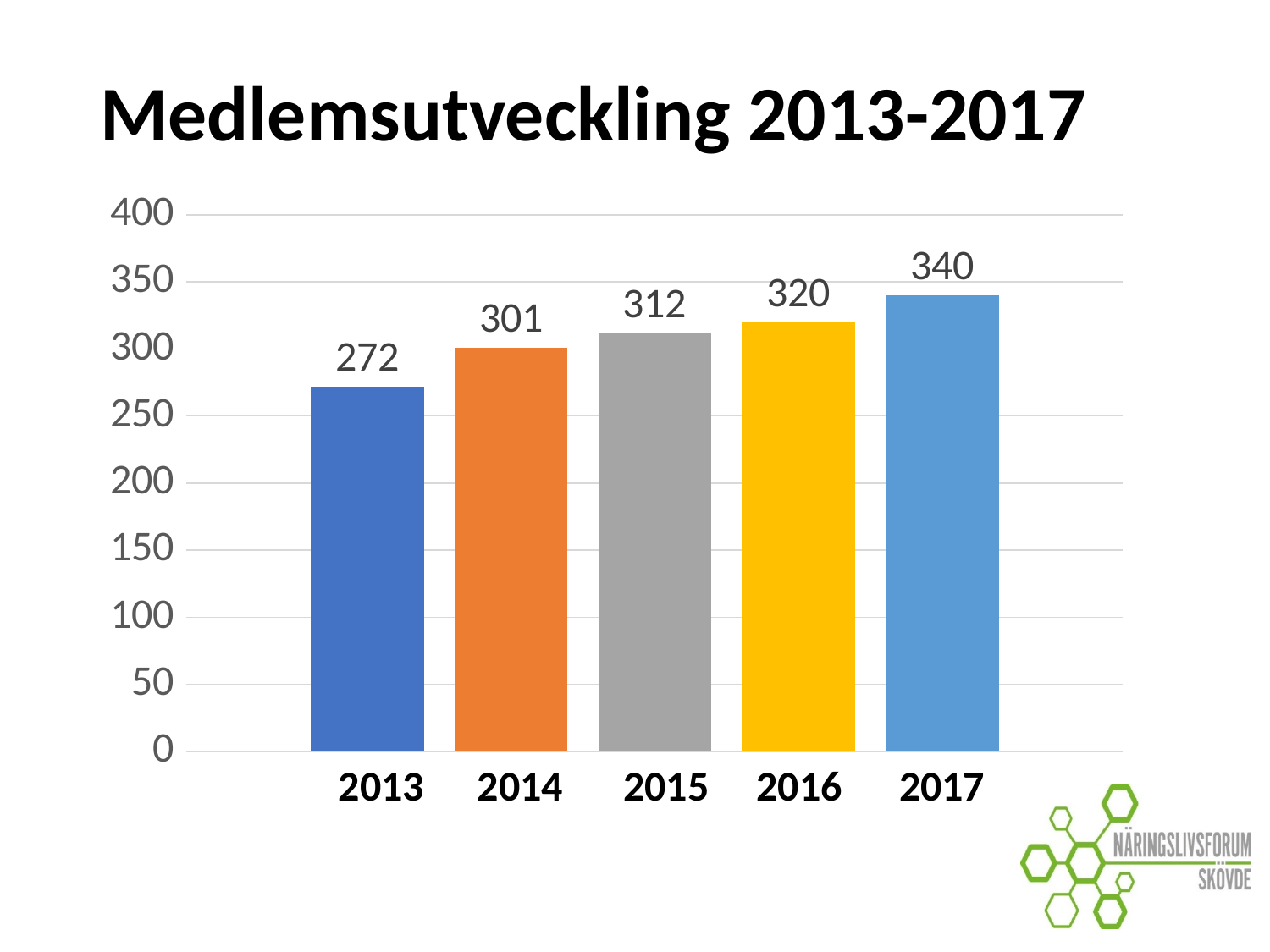
What is the value for 2017? 340 Is the value for 2013 greater or less than 250? greater Do the values rise or fall from 2013 to 2017? rise What is the value for 2015? 312 Which year has the highest value? 2017 What is the difference between the values for 2017 and 2013? 68 What is the difference between the values for 2014 and 2013? 29 What is the value for 2013? 272 Which year has the lowest value? 2013 How many years are shown on the x axis? 5 What kind of chart is shown on the slide? bar chart Which is larger, the value for 2016 or the value for 2014? 2016